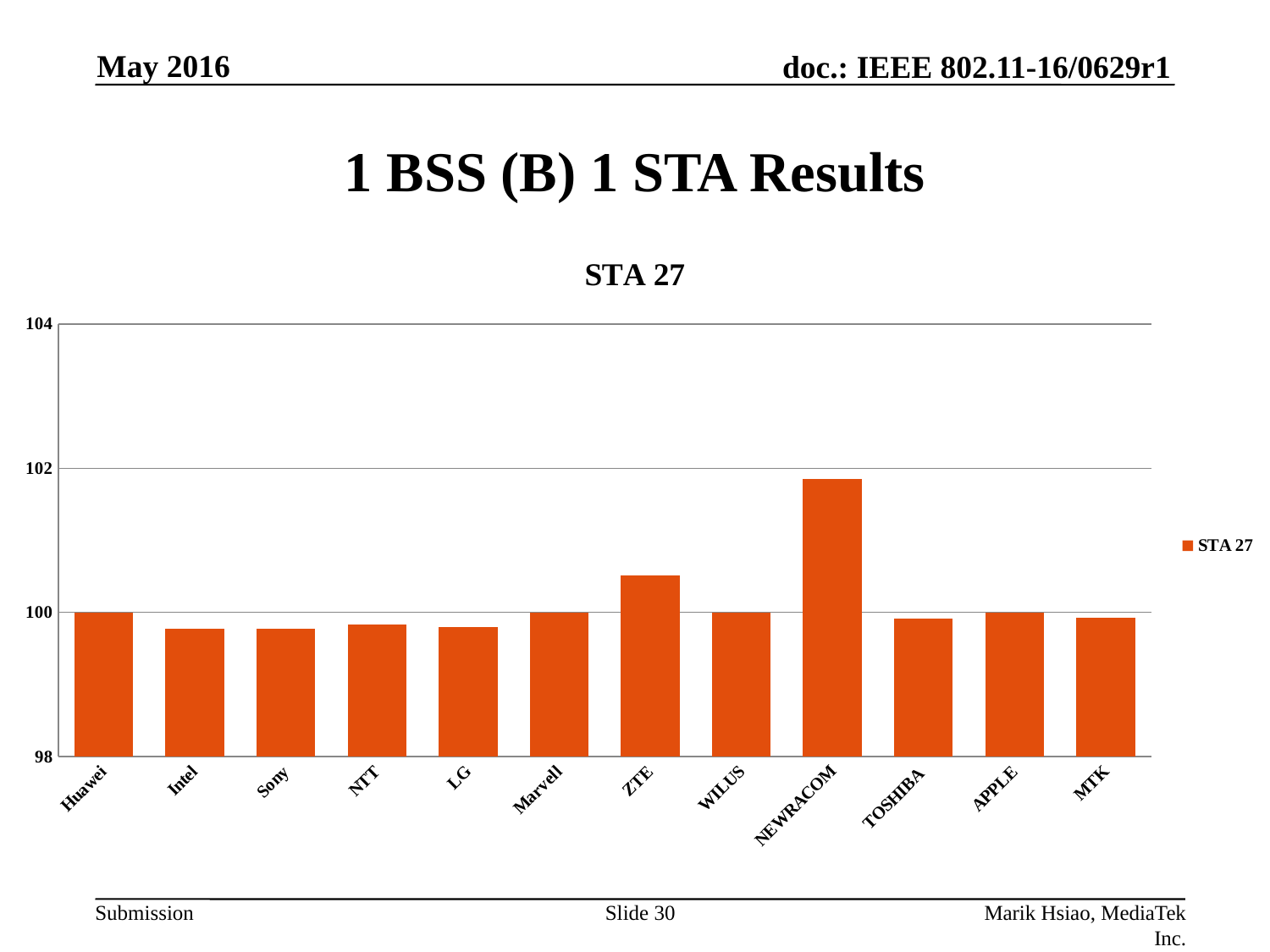
Which is larger, the value for ZTE or the value for Sony? ZTE What is the value for Huawei in the chart? 100 What is the title of the chart? STA 27 How many series does the legend list? 1 Which category has the highest value in the chart? NEWRACOM Is the value for NEWRACOM greater or less than 102? less Is the value for NEWRACOM greater or less than 100? greater Is the value for ZTE greater or less than 100? greater What kind of chart is shown on the slide? bar chart Which is larger, the value for NEWRACOM or the value for ZTE? NEWRACOM How many categories are shown on the x axis of the chart? 12